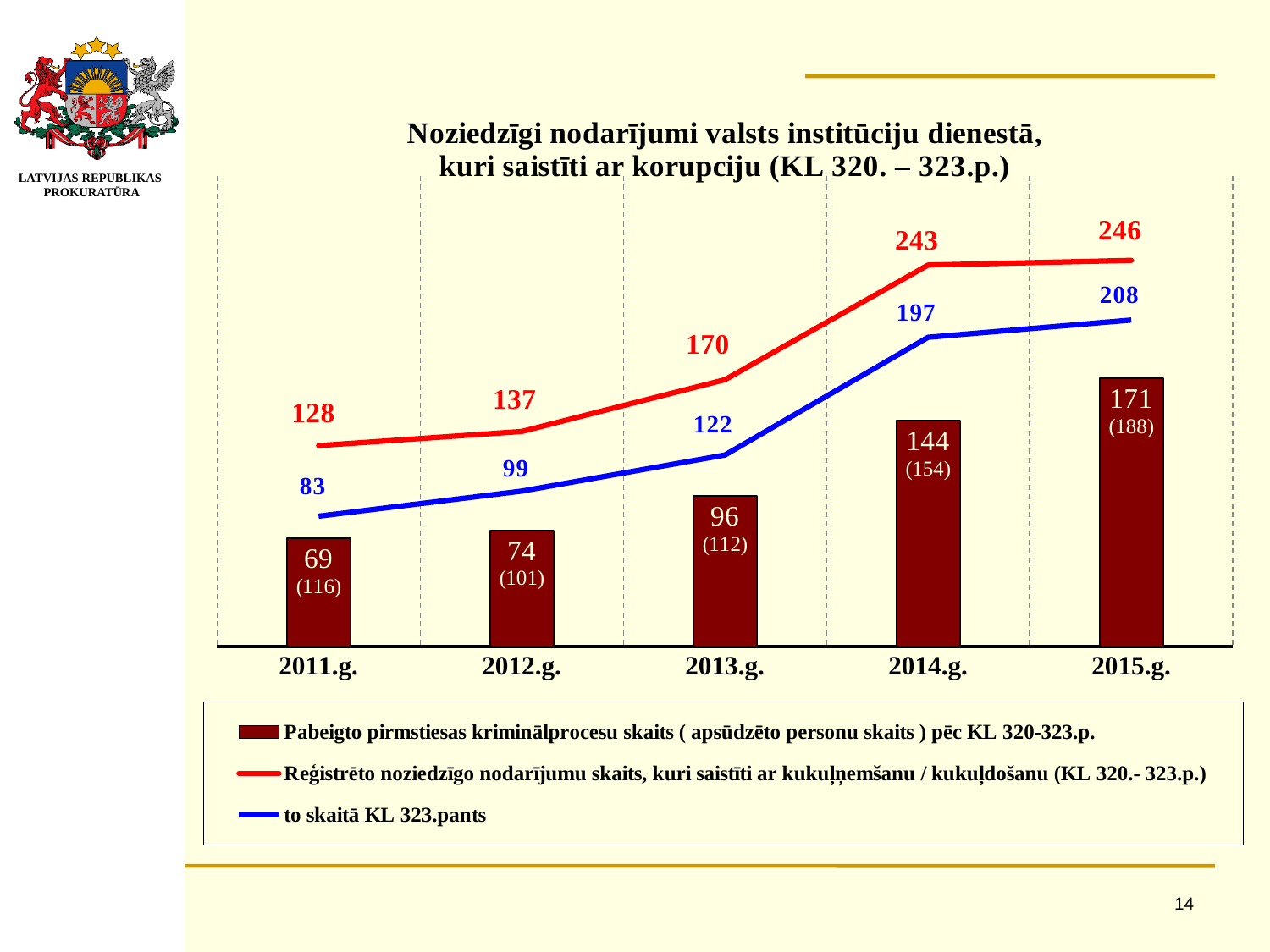
What is the value of the blue line (to skaitā KL 323.pants) for 2013.g.? 122 Does the red line rise or fall from 2011.g. to 2015.g.? rise What number is shown in parentheses on the bar for 2011.g.? 116 In which year is the red line at its lowest value? 2011.g. What is the difference between the blue line values for 2015.g. and 2011.g.? 125 What is the difference between the red line values for 2014.g. and 2013.g.? 73 How many years are shown on the x axis? 5 What is the value of the red line (Reģistrēto noziedzīgo nodarījumu skaits) for 2015.g.? 246 Which is larger: the blue line value for 2012.g. or the bar value for 2012.g.? the blue line value (99) In which year is the bar series at its highest value? 2015.g. What is the bar value (Pabeigto pirmstiesas kriminālprocesu skaits) for 2014.g.? 144 How many series does the legend list? 3